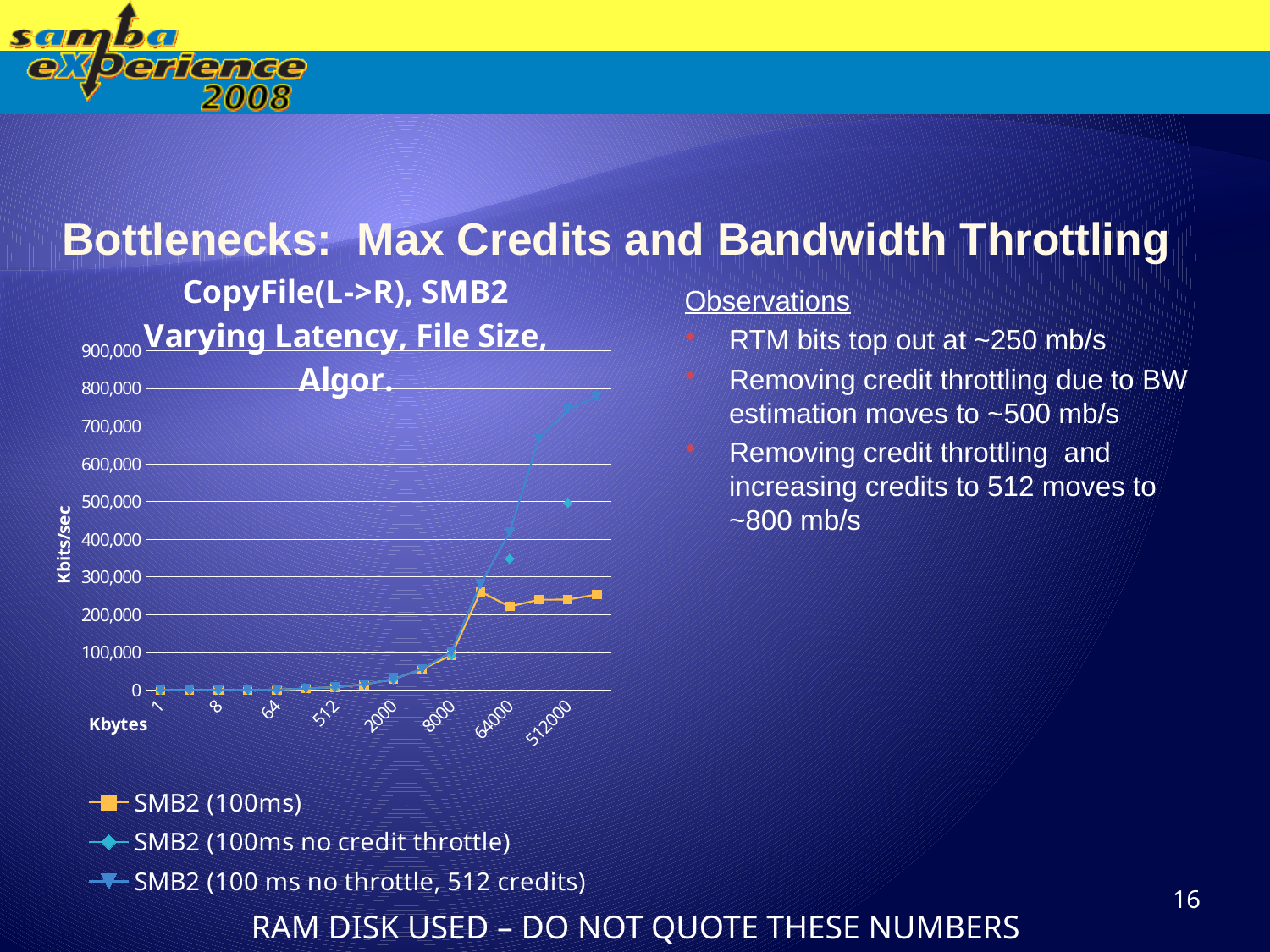
What is the label on the horizontal axis of the chart? Kbytes Is the value for SMB2 (100ms no credit throttle) at 512000 Kbytes greater or less than 400,000? greater Which series has the lowest value at 512000 Kbytes? SMB2 (100ms) Is the value for SMB2 (100ms) at 512000 Kbytes greater or less than 300,000? less What is the label on the vertical axis of the chart? Kbits/sec Which series reaches the highest value at 512000 Kbytes? SMB2 (100 ms no throttle, 512 credits) Is the value for SMB2 (100 ms no throttle, 512 credits) at 512000 Kbytes greater or less than 700,000? greater At 512000 Kbytes, which is larger: SMB2 (100ms no credit throttle) or SMB2 (100ms)? SMB2 (100ms no credit throttle) How many labeled categories are shown on the horizontal axis? 8 How many series does the chart legend list? 3 What kind of chart is shown on the slide? line chart Do the values for SMB2 (100 ms no throttle, 512 credits) generally rise or fall as Kbytes increase along the x axis? rise